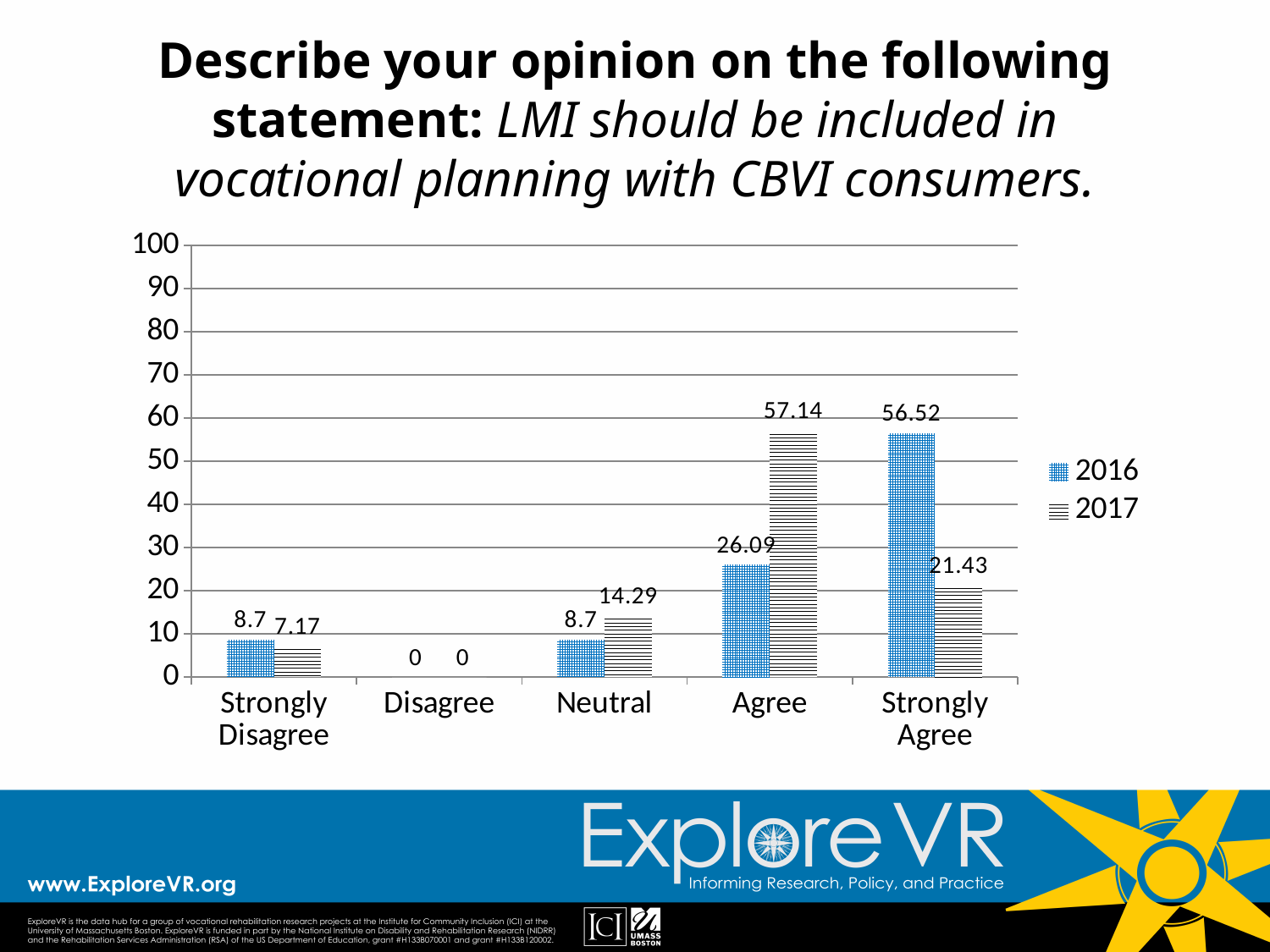
Which category has the lowest value for both 2016 and 2017? Disagree What is the 2016 value for Agree? 26.09 Which category has the highest 2017 value? Agree For Strongly Disagree, which year has the larger value, 2016 or 2017? 2016 How many categories are shown on the x axis? 5 What is the difference between the 2017 and 2016 values for Agree? 31.05 What is the difference between the 2016 and 2017 values for Strongly Agree? 35.09 What kind of chart is shown on the slide? Bar chart What is the 2017 value for Strongly Agree? 21.43 Which category has the highest 2016 value? Strongly Agree How many series does the legend list? 2 What is the 2017 value for Neutral? 14.29